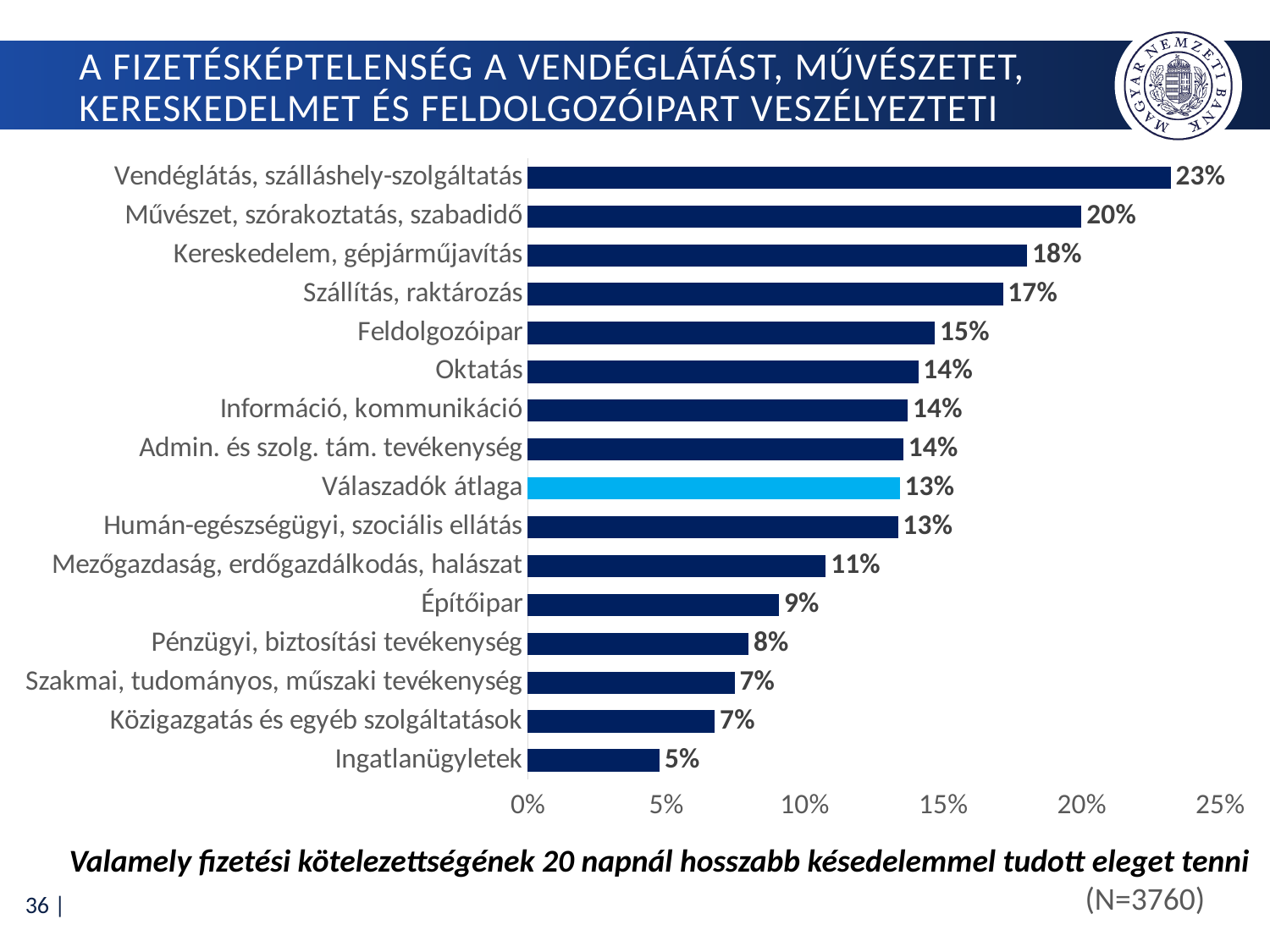
What is the difference between the values for Vendéglátás, szálláshely-szolgáltatás and Művészet, szórakoztatás, szabadidő? 3% Which category has the highest value? Vendéglátás, szálláshely-szolgáltatás What is the value for Válaszadók átlaga? 13% What is the value for Ingatlanügyletek? 5% Which category has the lowest value? Ingatlanügyletek What is the value for Feldolgozóipar? 15% What is the value for Vendéglátás, szálláshely-szolgáltatás? 23% Which is larger, the value for Építőipar or the value for Pénzügyi, biztosítási tevékenység? Építőipar How many categories are shown in the chart? 16 Is the value for Kereskedelem, gépjárműjavítás greater or less than 15%? greater What kind of chart is shown on the slide? Bar chart Which bar is shown in a lighter blue colour than the others? Válaszadók átlaga